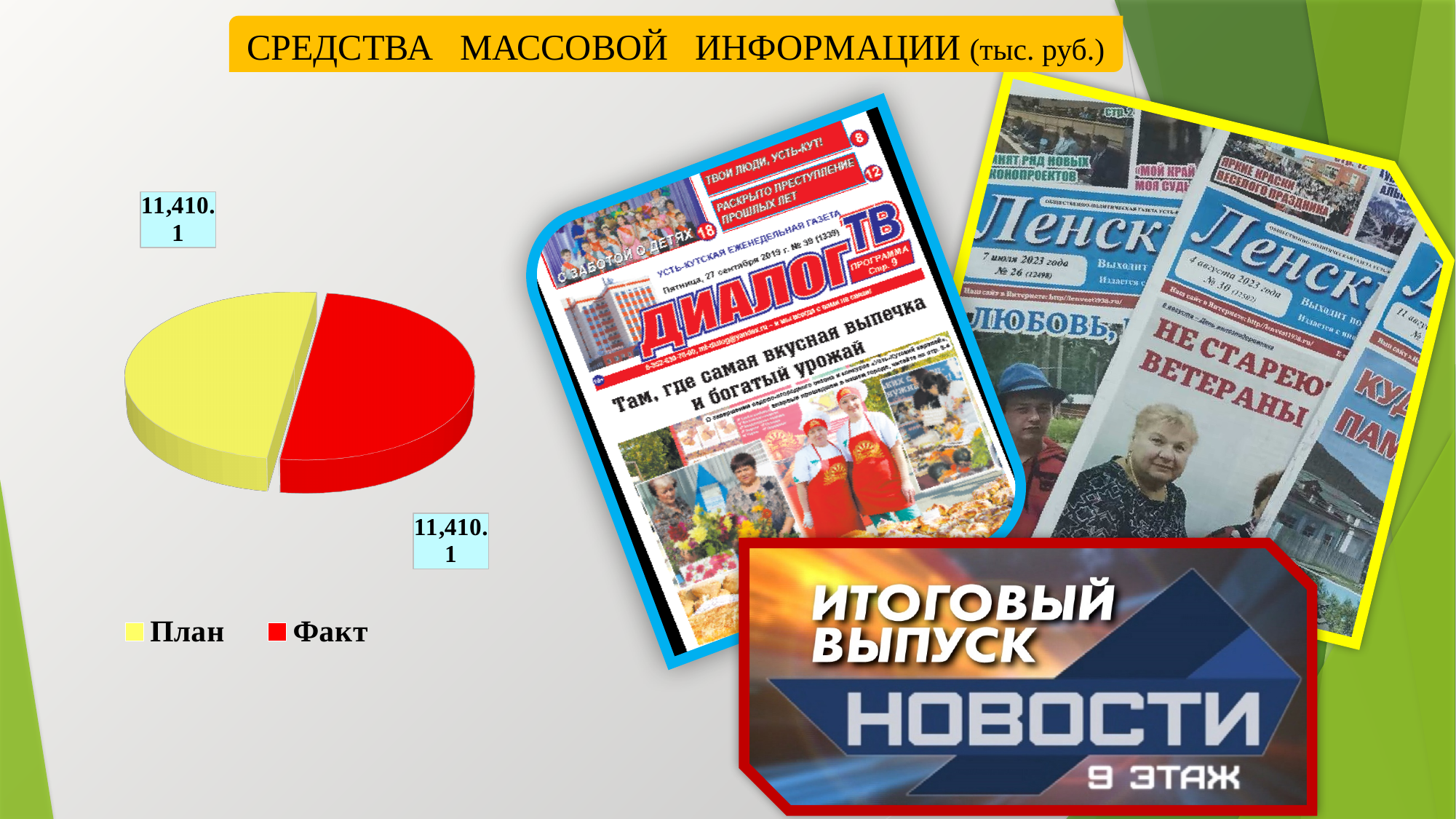
What is the title of the chart on the slide? СРЕДСТВА МАССОВОЙ ИНФОРМАЦИИ (тыс. руб.) How many slices does the pie chart have? 2 Which colour represents План in the pie chart? yellow What is the total of the two values shown in the pie chart? 22,820.2 What share of the pie does the Факт slice represent? 50% What is the difference between the План and Факт values in the pie chart? 0 What is the value for Факт (Fact) in the pie chart? 11,410.1 How many entries does the legend of the pie chart list? 2 What share of the pie does the План slice represent? 50% What type of chart is shown on the slide? pie chart What is the value for План (Plan) in the pie chart? 11,410.1